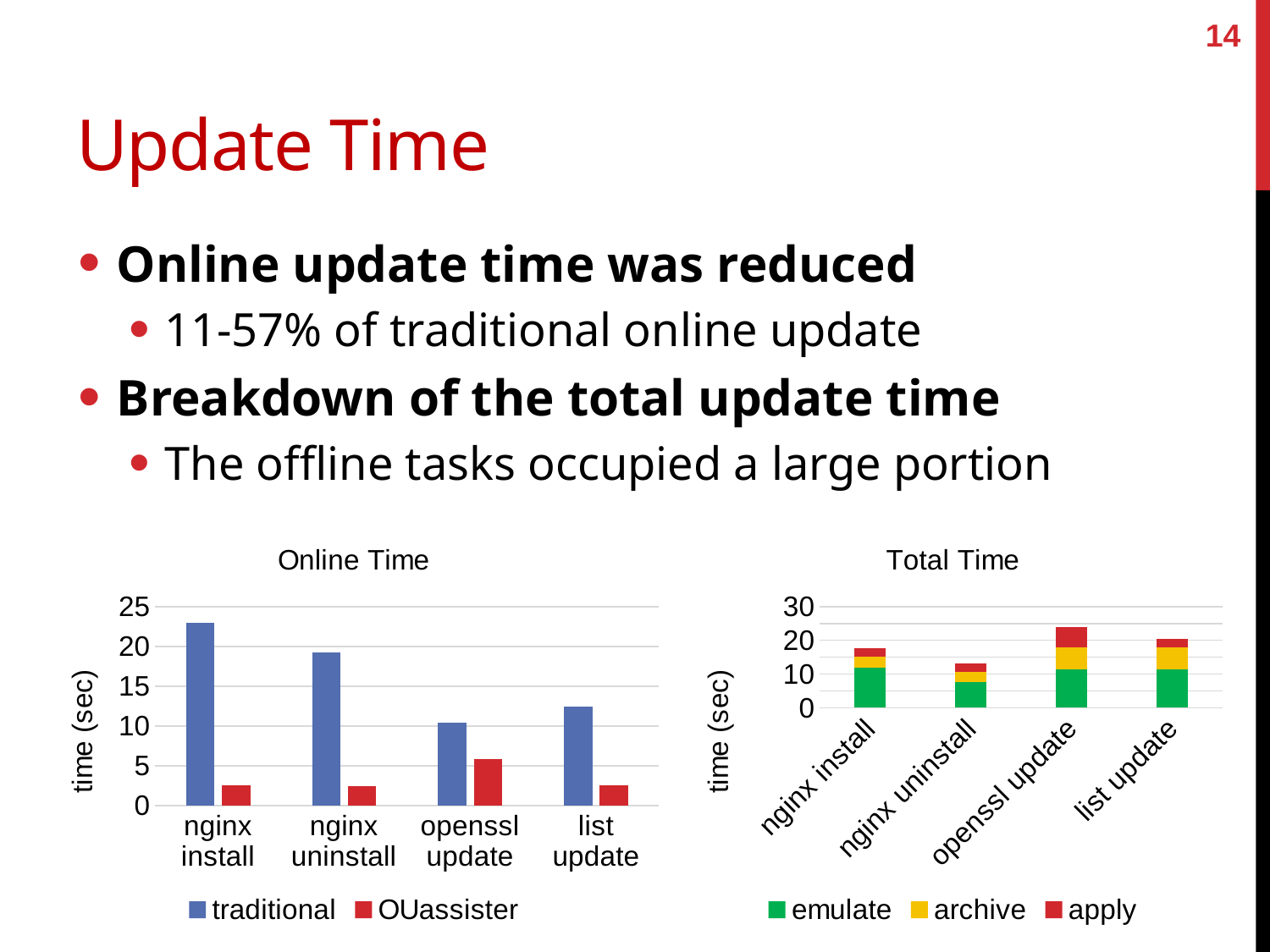
In the Online Time chart, which is larger: the traditional value for nginx uninstall or the traditional value for list update? nginx uninstall In the Total Time chart, how many series does the legend list? 3 In the Online Time chart, how many series does the legend list? 2 In the Online Time chart, how many categories are shown on the x axis? 4 In the Total Time chart, which colour represents the emulate series? green In the Online Time chart, is the OUassister value for openssl update greater or less than 5? greater In the Online Time chart, which category has the highest traditional value? nginx install In the Online Time chart, what kind of chart is shown? bar chart In the Total Time chart, which category has the tallest stacked bar? openssl update In the Online Time chart, is the traditional value for nginx install greater or less than 20? greater In the Online Time chart, which category has the highest OUassister value? openssl update In the Total Time chart, which category has the shortest stacked bar? nginx uninstall